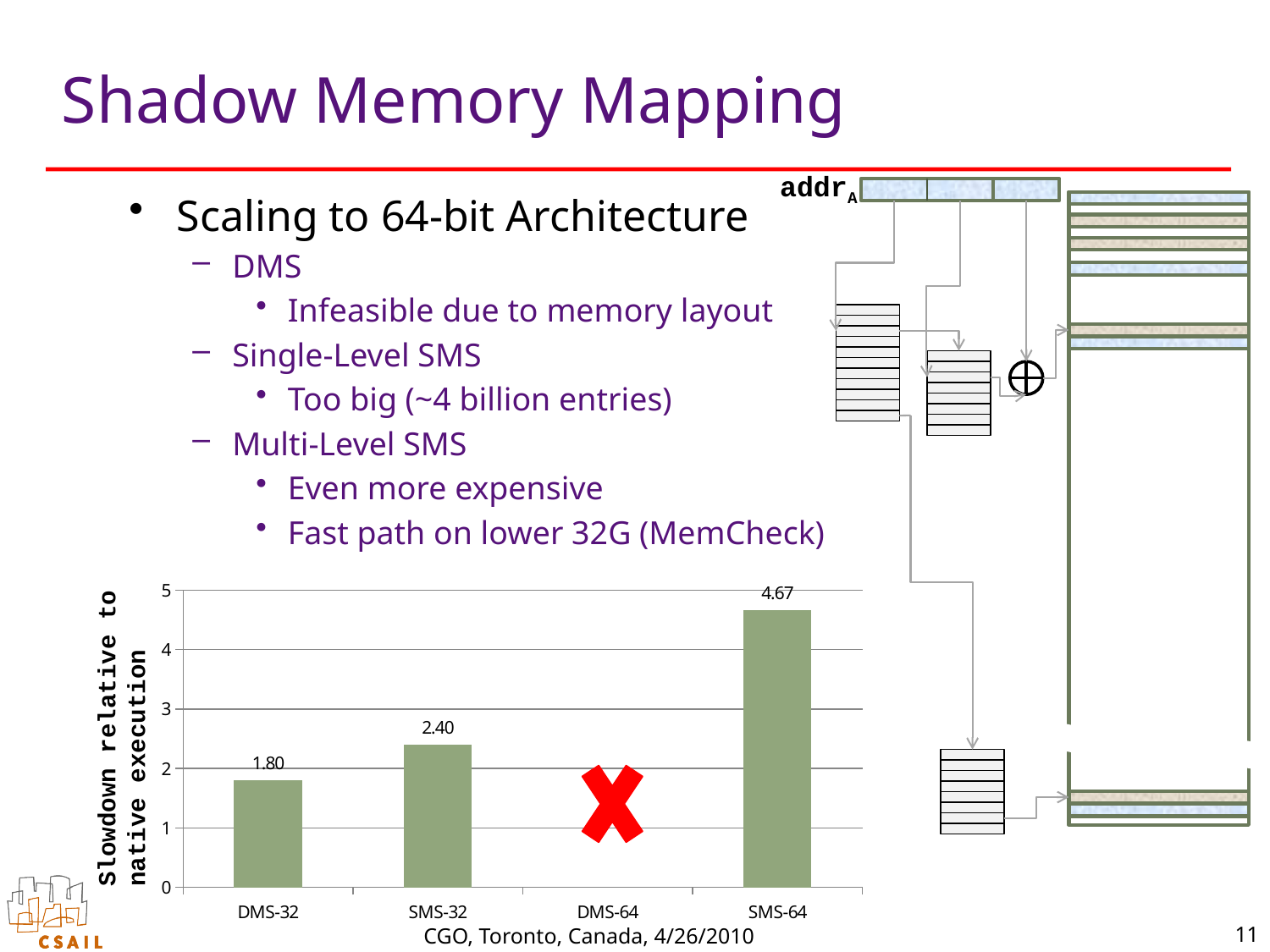
What is the slowdown relative to native execution for SMS-32? 2.40 What is the difference in slowdown between SMS-32 and DMS-32? 0.60 Is the slowdown for SMS-64 greater or less than 4? greater What is the difference in slowdown between SMS-64 and SMS-32? 2.27 Which category has the highest slowdown relative to native execution? SMS-64 What kind of chart is shown on the slide? bar chart How many categories are shown on the x axis of the chart? 4 Which has a larger slowdown, SMS-32 or DMS-32? SMS-32 Among the categories with a plotted bar, which has the lowest slowdown? DMS-32 What is the slowdown relative to native execution for DMS-32? 1.80 Which category on the x axis is marked with a red X instead of a bar? DMS-64 What is the slowdown relative to native execution for SMS-64? 4.67